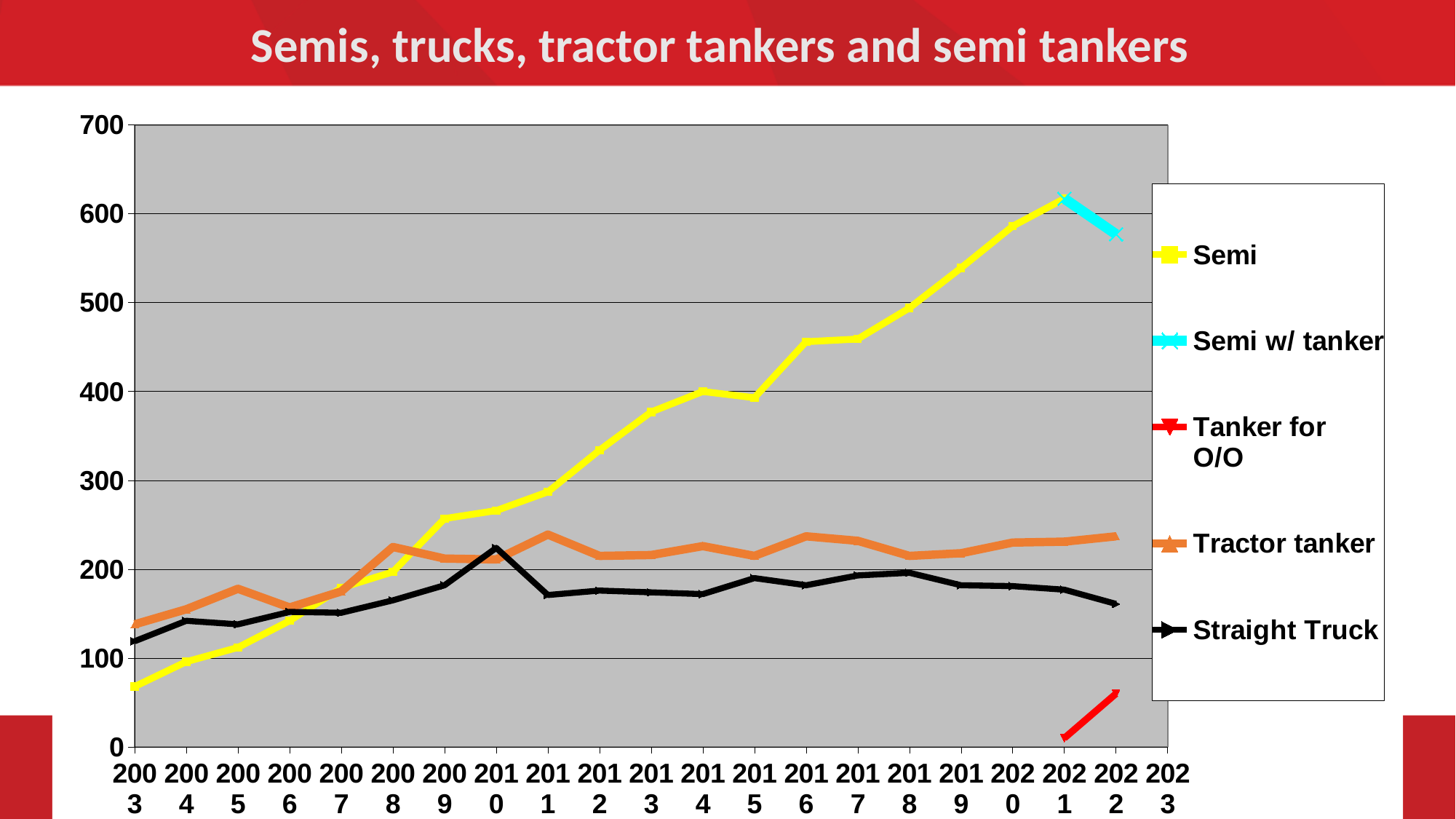
Is the value for Semi in 2003 greater or less than 100? less Is the value for Tanker for O/O in 2021 greater or less than 100? less Does the Semi series generally rise or fall from 2003 to 2021? rise What kind of chart is shown on the slide? line chart What colour is the Straight Truck line? black Which series has the highest value in 2022? Semi w/ tanker Is the value for Semi in 2021 greater or less than 500? greater How many year labels are shown along the x axis? 21 How many series does the legend list? 5 Which series has the lowest value in 2022? Tanker for O/O